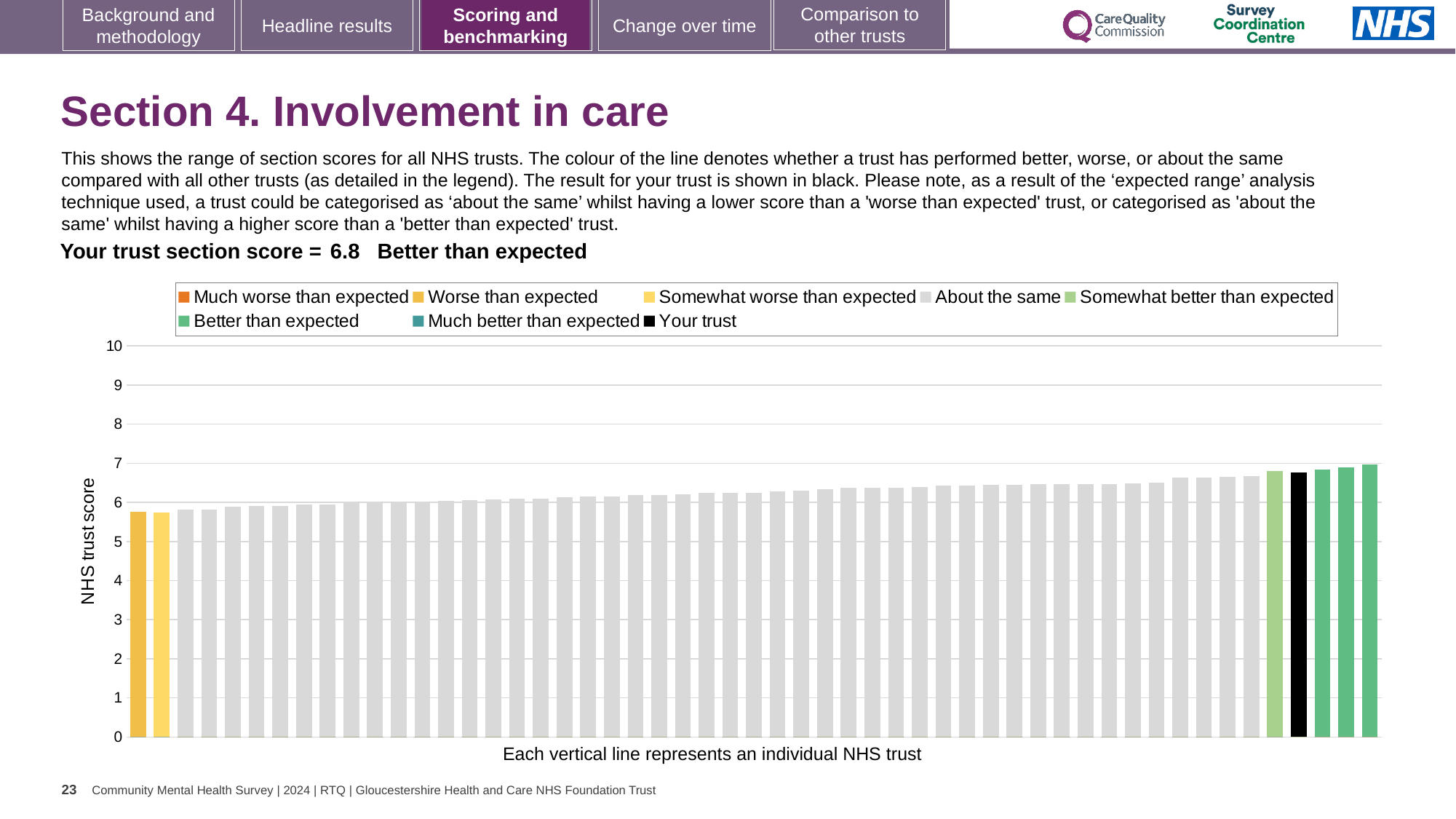
What is the maximum value shown on the vertical axis? 10 What colour is the bar representing your trust? black What kind of chart is shown on the slide? bar chart Do the bar values rise or fall from left to right along the x axis? rise Is the value for the lowest-scoring trust (the leftmost bar) greater or less than 6? less Is the value for your trust (the black bar) greater or less than 6? greater Is the value for the highest-scoring trust (the rightmost bar) greater or less than 8? less How many entries does the chart legend list? 8 What is the section score for your trust shown on the slide? 6.8 What is the label on the vertical axis of the chart? NHS trust score Which performance category is your trust's section score assigned to? Better than expected